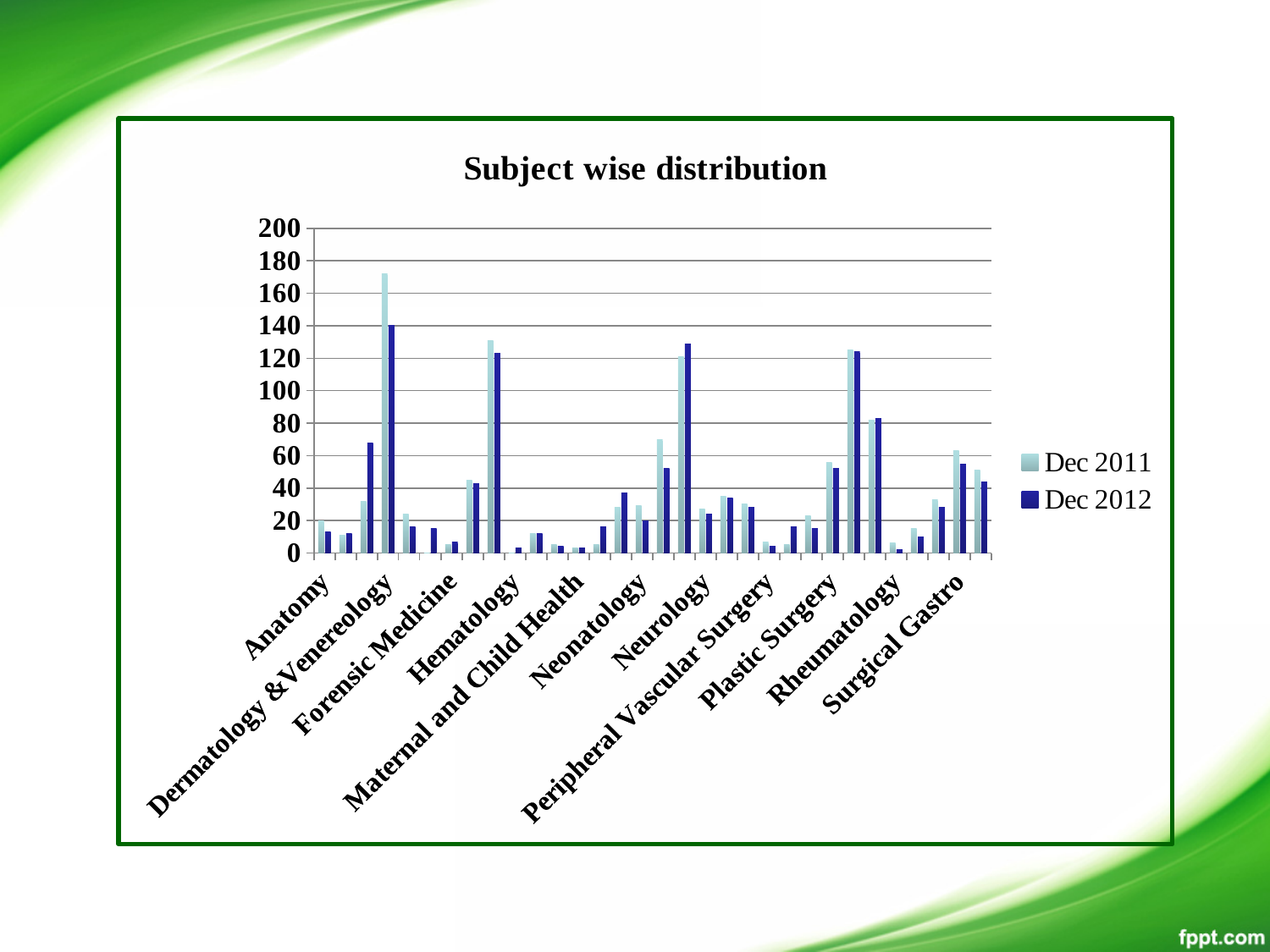
Which series contains the tallest bar on the chart, Dec 2011 or Dec 2012? Dec 2011 What kind of chart is shown on the slide? bar chart Is the tallest bar for Dec 2012 greater or less than 160? less What are the two series named in the legend? Dec 2011 and Dec 2012 What is the interval between consecutive tick labels on the vertical axis? 20 What is the title of the chart? Subject wise distribution Is the tallest bar for Dec 2011 greater or less than 160? greater How many subject labels are printed along the horizontal axis? 11 How many series does the legend list? 2 What is the highest value shown on the vertical axis? 200